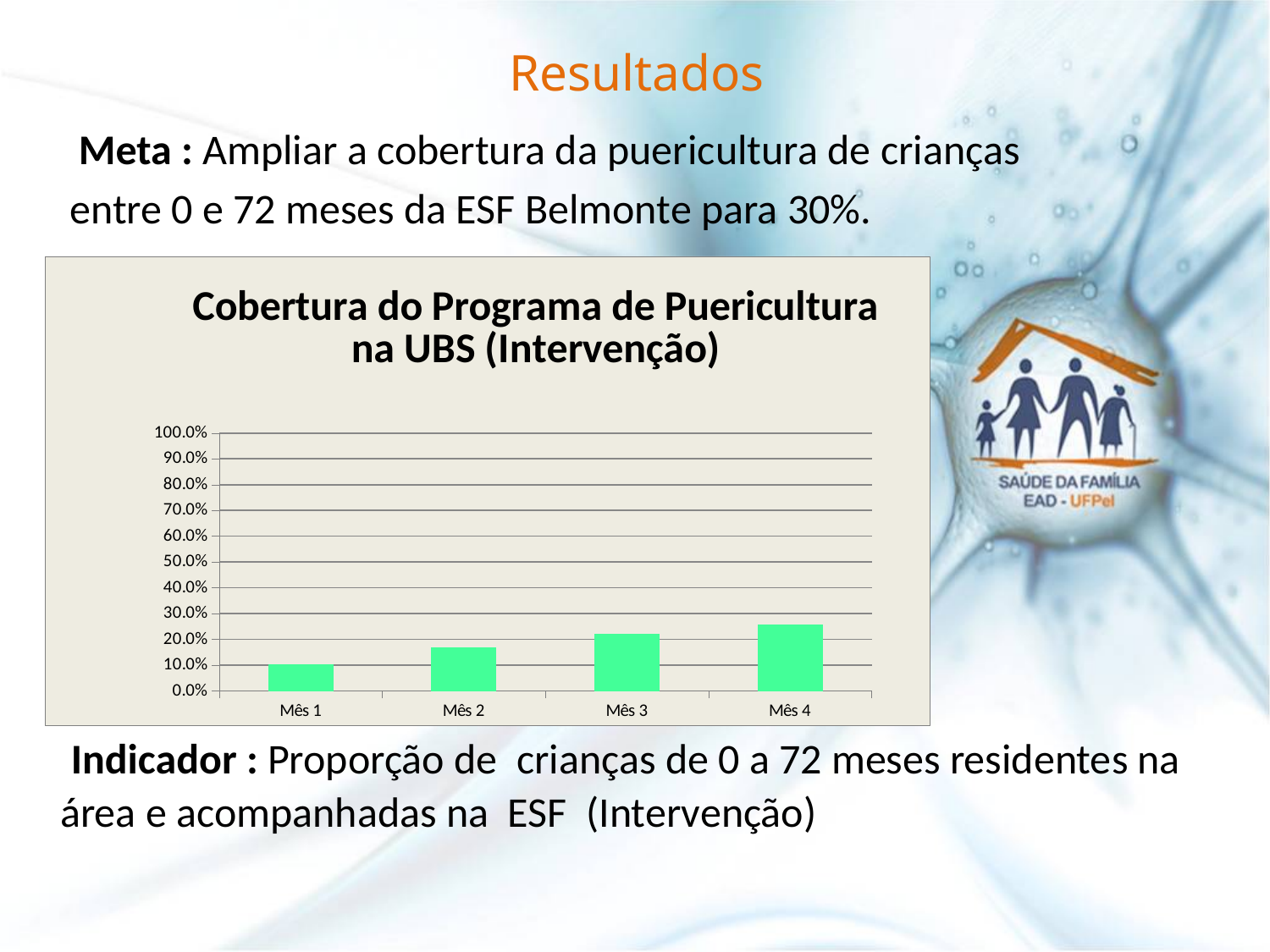
Do the values rise or fall from Mês 1 to Mês 4? rise Which is larger, the value for Mês 3 or the value for Mês 1? Mês 3 What is the title of the chart? Cobertura do Programa de Puericultura na UBS (Intervenção) What is the highest value shown on the y axis of the chart? 100.0% What type of chart is shown on the slide? bar chart Is the value for Mês 2 greater or less than 20.0%? less How many months (categories) are plotted on the x axis of the chart? 4 Is the value for Mês 1 greater or less than 20.0%? less Is the value for Mês 4 greater or less than 30.0%? less Which month has the lowest coverage in the chart? Mês 1 Which month has the highest coverage in the chart? Mês 4